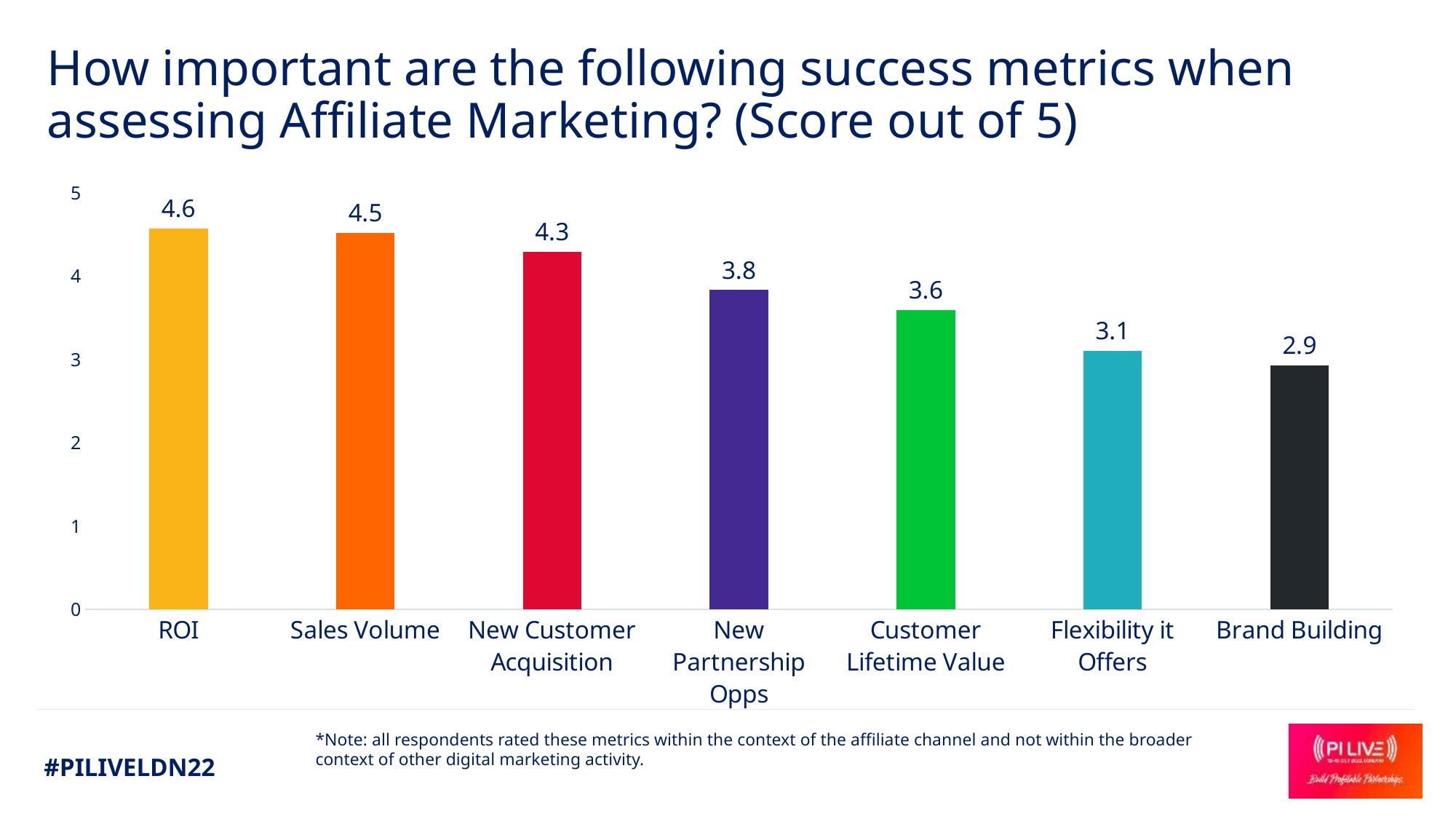
What is the score for New Partnership Opps? 3.8 Is the score for Flexibility it Offers greater or less than 3? greater What is the score for ROI? 4.6 Which success metric has the highest score? ROI What kind of chart is shown on the slide? Bar chart Do the scores rise or fall from left to right across the chart? Fall What is the difference between the scores for New Customer Acquisition and Customer Lifetime Value? 0.7 Which has a higher score, Customer Lifetime Value or Flexibility it Offers? Customer Lifetime Value Which success metric has the lowest score? Brand Building How many success metrics are shown in the chart? 7 What is the score for Brand Building? 2.9 What is the difference between the scores for ROI and Brand Building? 1.7